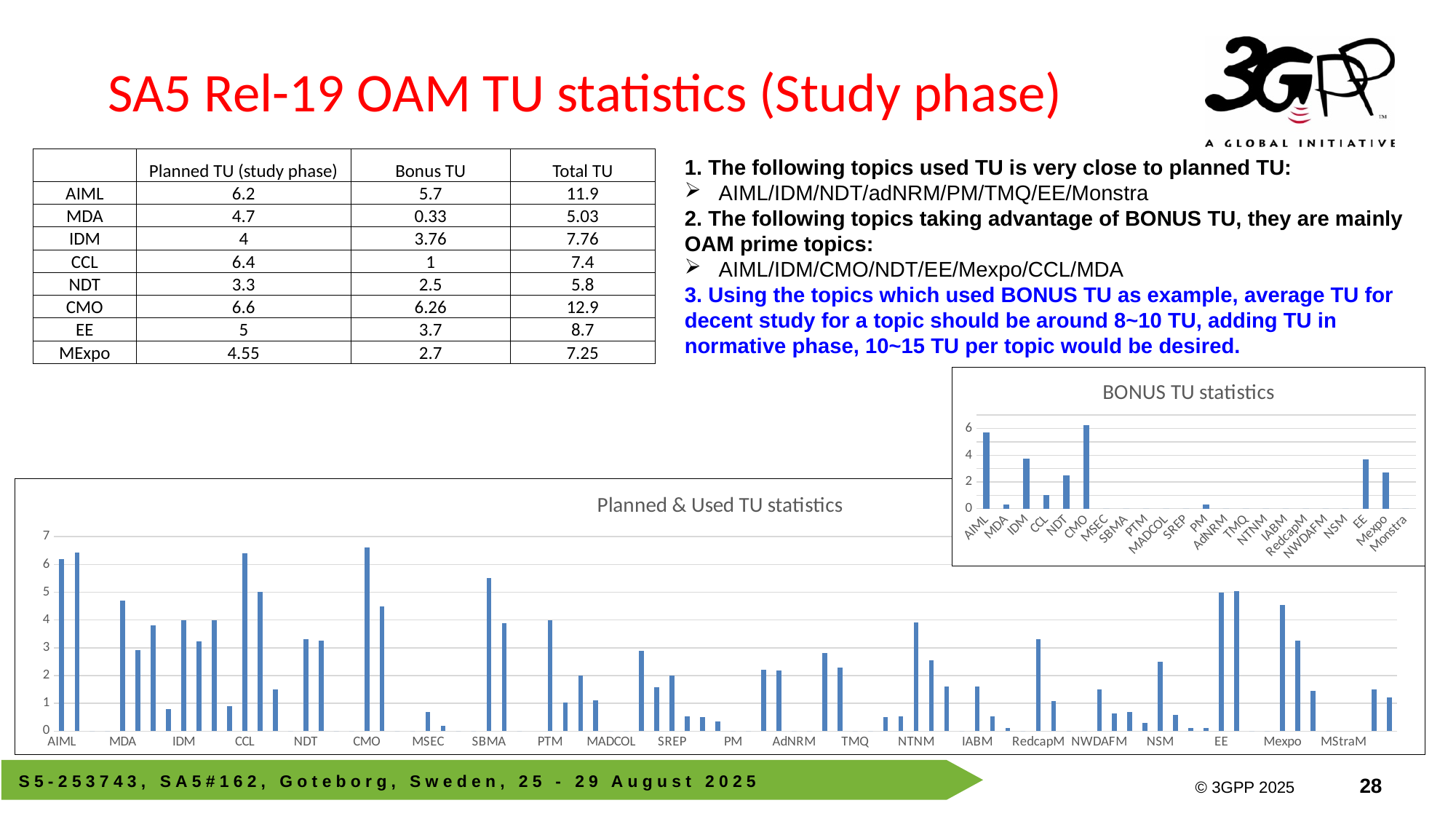
What is the title of the large chart at the bottom of the slide? Planned & Used TU statistics In the "BONUS TU statistics" chart, which is larger, the value for NDT or the value for CCL? NDT What kind of chart is the "BONUS TU statistics" chart? bar chart In the "BONUS TU statistics" chart, which category has the highest bar? CMO In the "BONUS TU statistics" chart, which is larger, the value for AIML or the value for IDM? AIML In the "BONUS TU statistics" chart, is the value for EE greater or less than 2? greater In the "BONUS TU statistics" chart, is the value for MDA greater or less than 2? less In the "BONUS TU statistics" chart, is the value for AIML greater or less than 4? greater How many categories are shown on the x axis of the "Planned & Used TU statistics" chart? 22 How many categories are shown on the x axis of the "BONUS TU statistics" chart? 22 What kind of chart is the "Planned & Used TU statistics" chart? bar chart